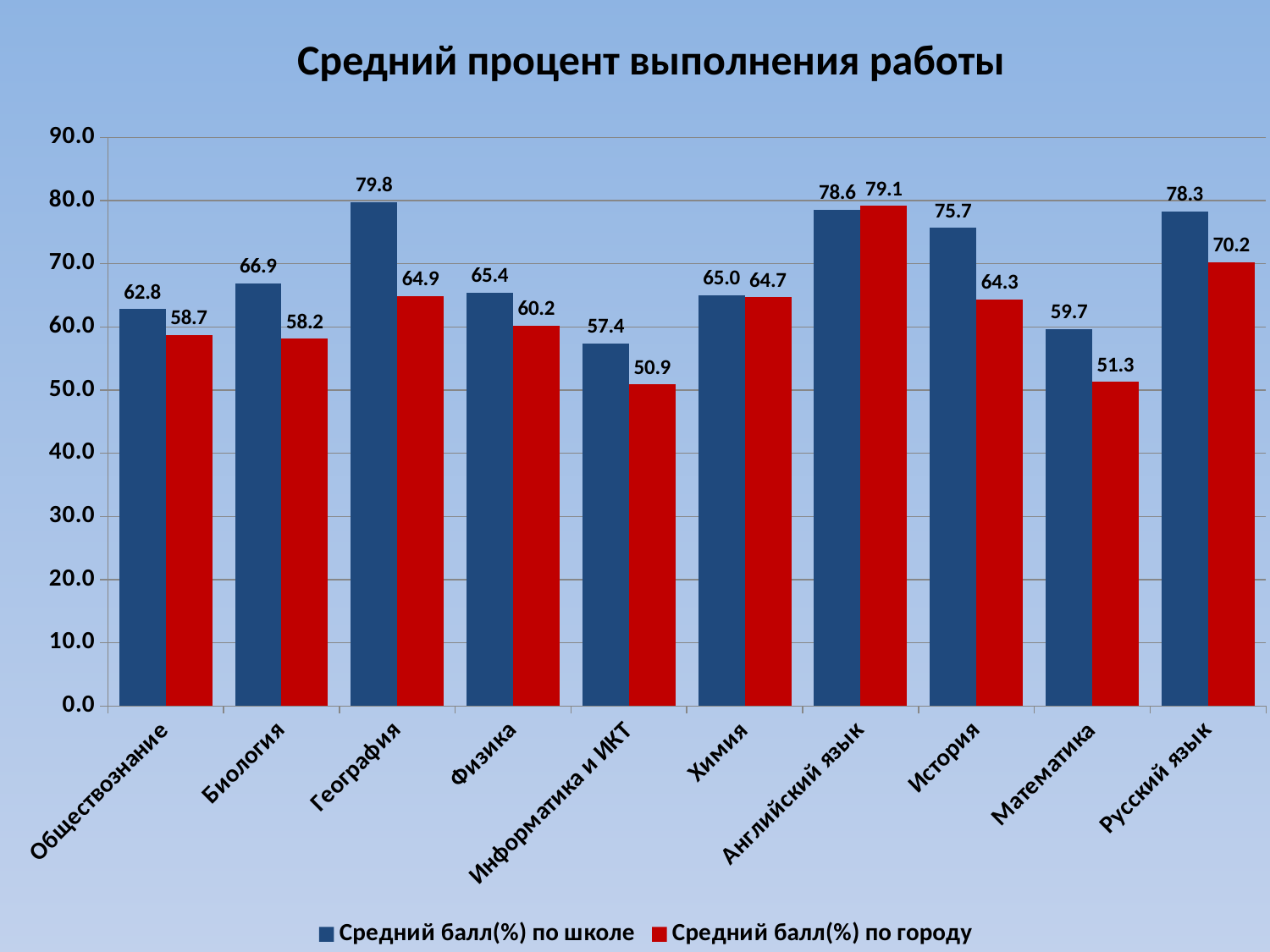
What is the value for Математика in the series Средний балл(%) по городу? 51.3 What is the value for Русский язык in the series Средний балл(%) по городу? 70.2 What is the difference between the school value and the city value for История? 11.4 What is the value for Биология in the series Средний балл(%) по школе? 66.9 How many series does the legend list? 2 How many categories are shown on the x axis? 10 For Английский язык, which is larger: the value for Средний балл(%) по школе or Средний балл(%) по городу? Средний балл(%) по городу Which category has the lowest value in the series Средний балл(%) по городу? Информатика и ИКТ Which category has the highest value in the series Средний балл(%) по школе? География What is the title of the chart? Средний процент выполнения работы Is the value for Физика in the series Средний балл(%) по городу greater or less than 70.0? less What kind of chart is shown on the slide? bar chart